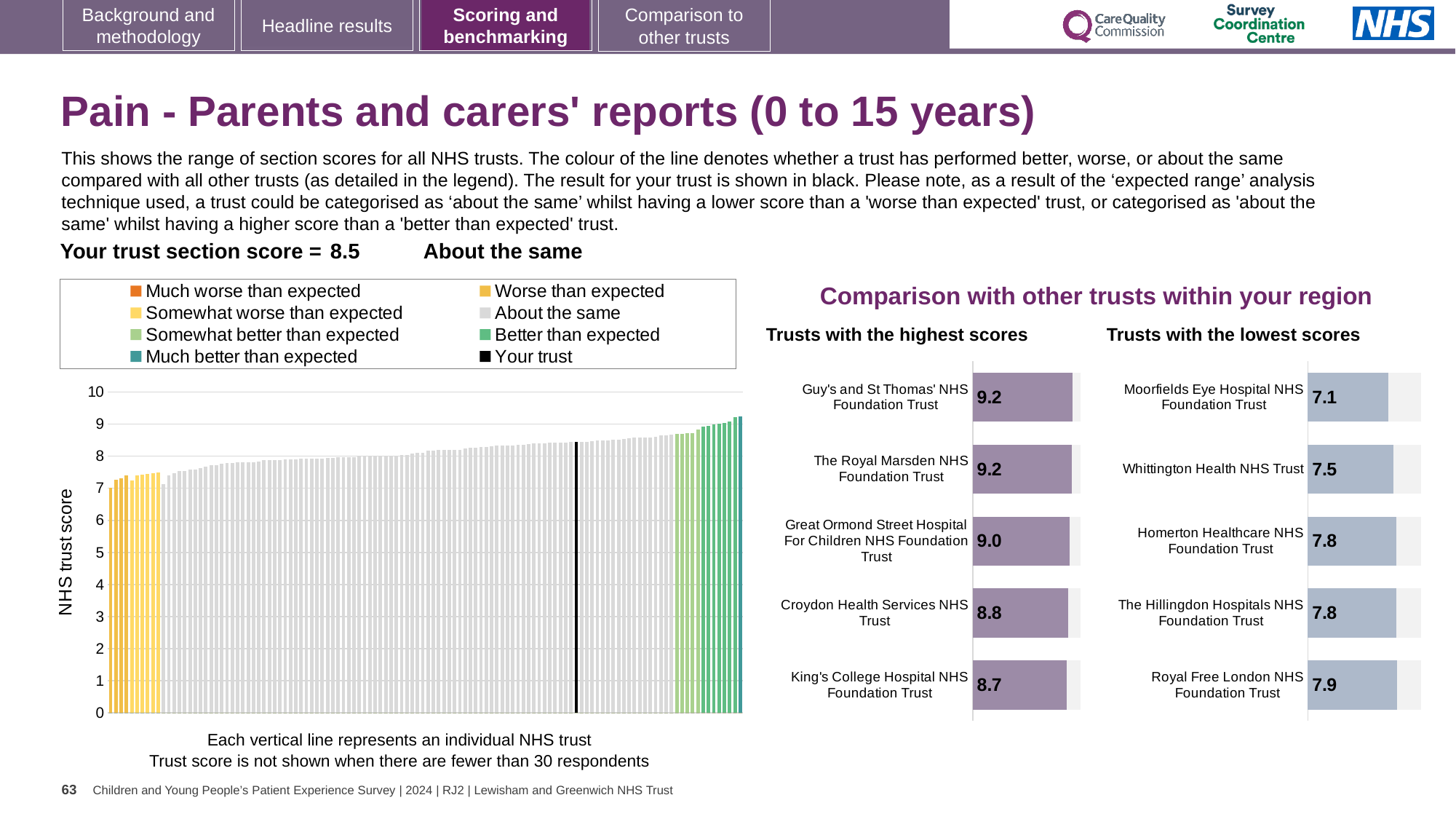
How many entries does the legend of the large chart on the left list? 8 In the 'Trusts with the lowest scores' chart, which trust has the lowest score? Moorfields Eye Hospital NHS Foundation Trust In the large chart on the left showing all NHS trusts, is the value for the black 'Your trust' bar greater or less than 8? greater In the 'Trusts with the lowest scores' chart, what is the score for Whittington Health NHS Trust? 7.5 How many trusts are shown in the 'Trusts with the lowest scores' chart? 5 Which is larger: the score for Croydon Health Services NHS Trust in the highest scores chart or the score for Whittington Health NHS Trust in the lowest scores chart? Croydon Health Services NHS Trust In the 'Trusts with the highest scores' chart, which trust has the lowest score shown? King's College Hospital NHS Foundation Trust In the 'Trusts with the lowest scores' chart, what is the difference between the scores of Royal Free London NHS Foundation Trust and Moorfields Eye Hospital NHS Foundation Trust? 0.8 In the 'Trusts with the highest scores' chart, what is the difference between the scores of Guy's and St Thomas' NHS Foundation Trust and King's College Hospital NHS Foundation Trust? 0.5 In the 'Trusts with the highest scores' chart, what is the score for Guy's and St Thomas' NHS Foundation Trust? 9.2 In the 'Trusts with the lowest scores' chart, what is the score for Moorfields Eye Hospital NHS Foundation Trust? 7.1 In the 'Trusts with the highest scores' chart, what is the score for Croydon Health Services NHS Trust? 8.8